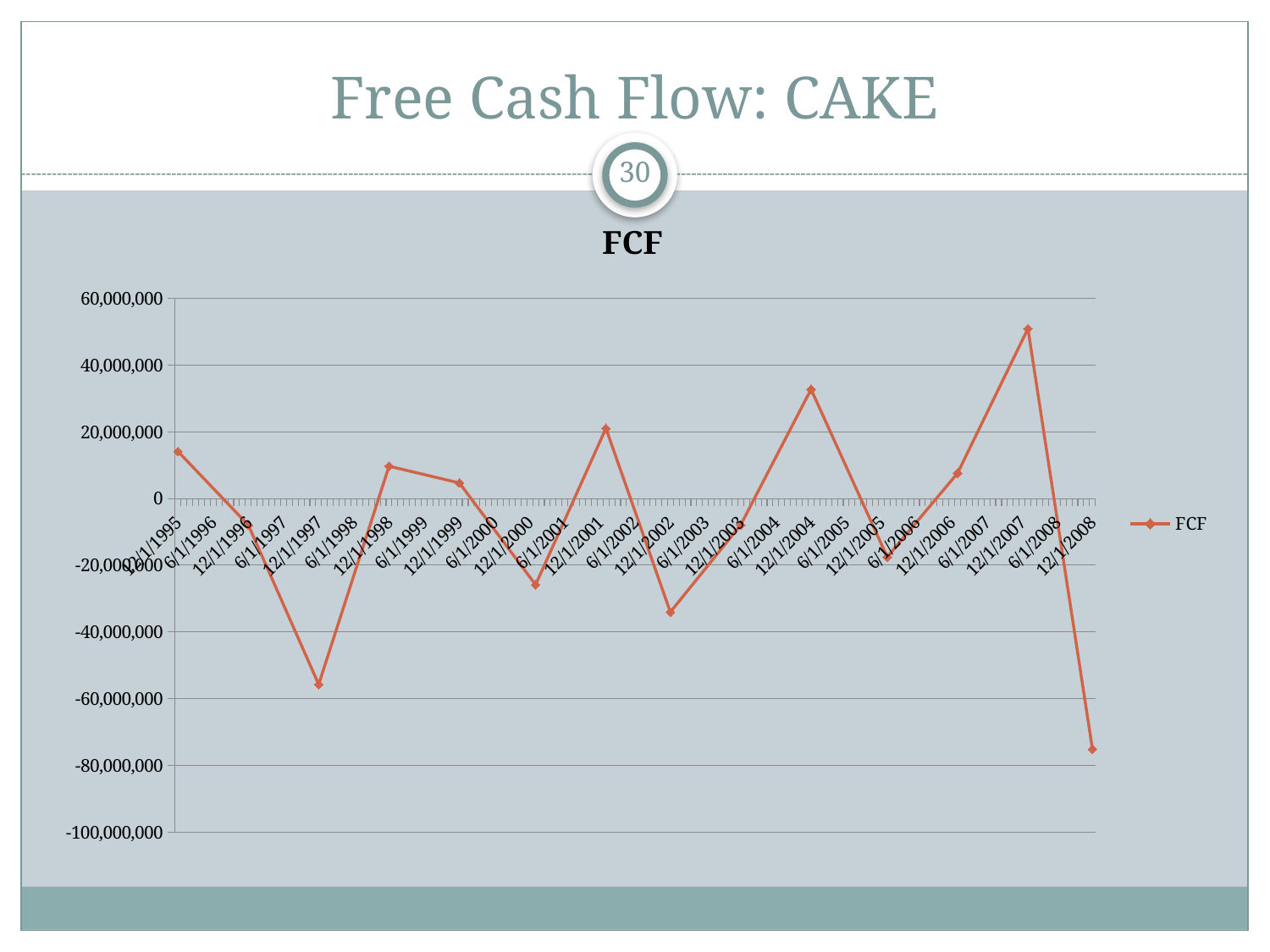
How many series does the legend list? 1 Is the FCF value at 12/1/1997 greater or less than -40,000,000? less Is the FCF value at 12/1/2004 greater or less than 20,000,000? greater What is the title of the chart? FCF Is the FCF value at 12/1/2008 greater or less than -60,000,000? less At which date does the FCF line reach its lowest value? 12/1/2008 At which date does the FCF line reach its highest value? 12/1/2007 What kind of chart is shown on the slide? Line chart Does the FCF line rise or fall between 12/1/2005 and 12/1/2007? Rise Which is larger, the FCF value at 12/1/2004 or at 12/1/2001? 12/1/2004